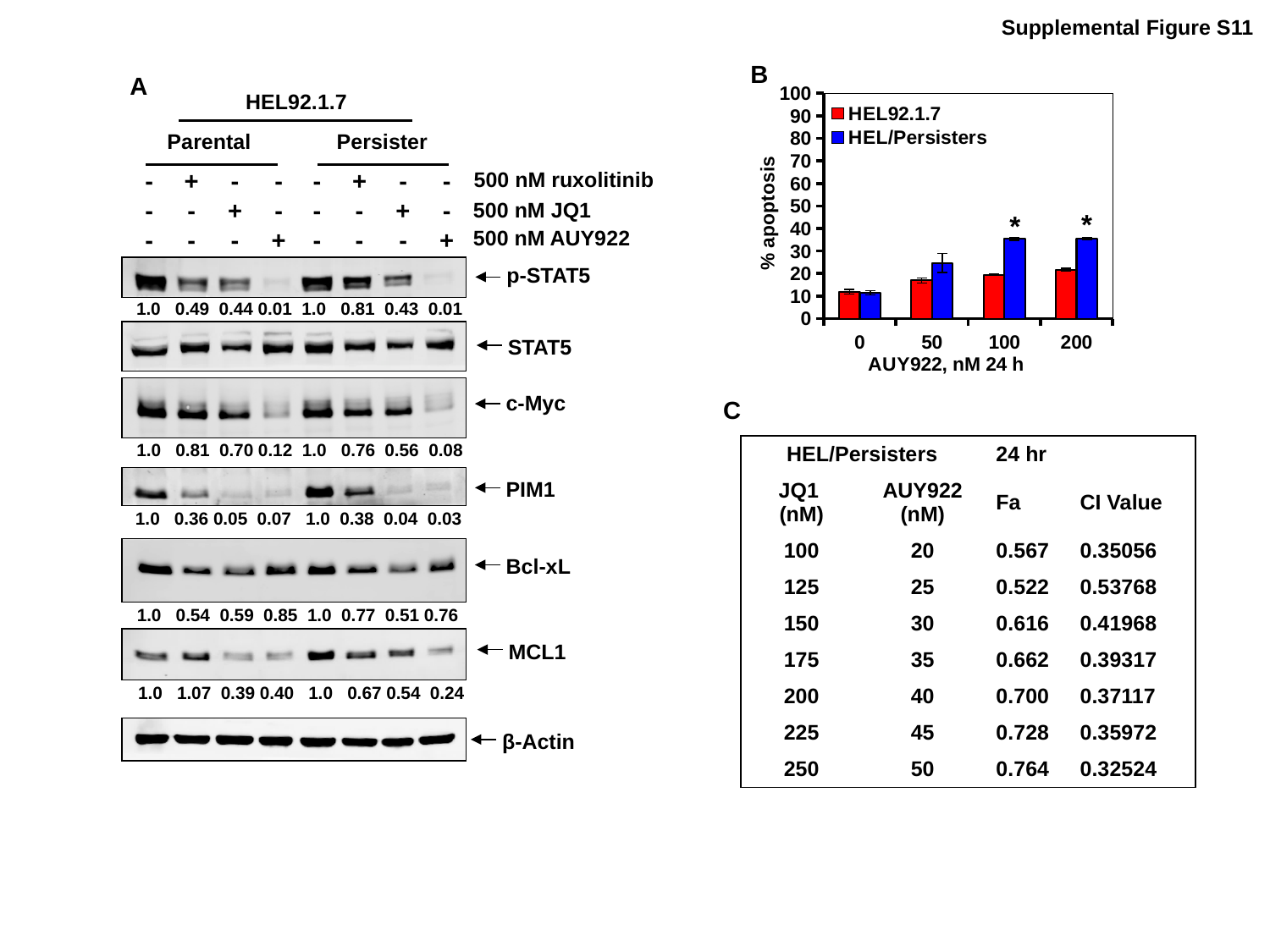
In the chart in panel B, at which AUY922 concentration is the HEL/Persisters value lowest? 0 In the chart in panel B, is the value for HEL/Persisters at 50 nM AUY922 greater or less than 20? greater In the chart in panel B, does the % apoptosis for HEL/Persisters rise or fall as the AUY922 concentration increases? rise In the chart in panel B, how many AUY922 concentrations are shown on the x axis? 4 In the chart in panel B, is the value for HEL/Persisters at 100 nM AUY922 greater or less than 30? greater In the chart in panel B, which colour represents HEL/Persisters in the legend? blue In the chart in panel B, is the value for HEL92.1.7 at 200 nM AUY922 greater or less than 30? less In the chart in panel B, how many series does the legend list? 2 In the chart in panel B, what kind of chart is shown? bar chart In the chart in panel B, at 100 nM AUY922, which series has the larger % apoptosis, HEL92.1.7 or HEL/Persisters? HEL/Persisters In the chart in panel B, what is the label on the y axis? % apoptosis